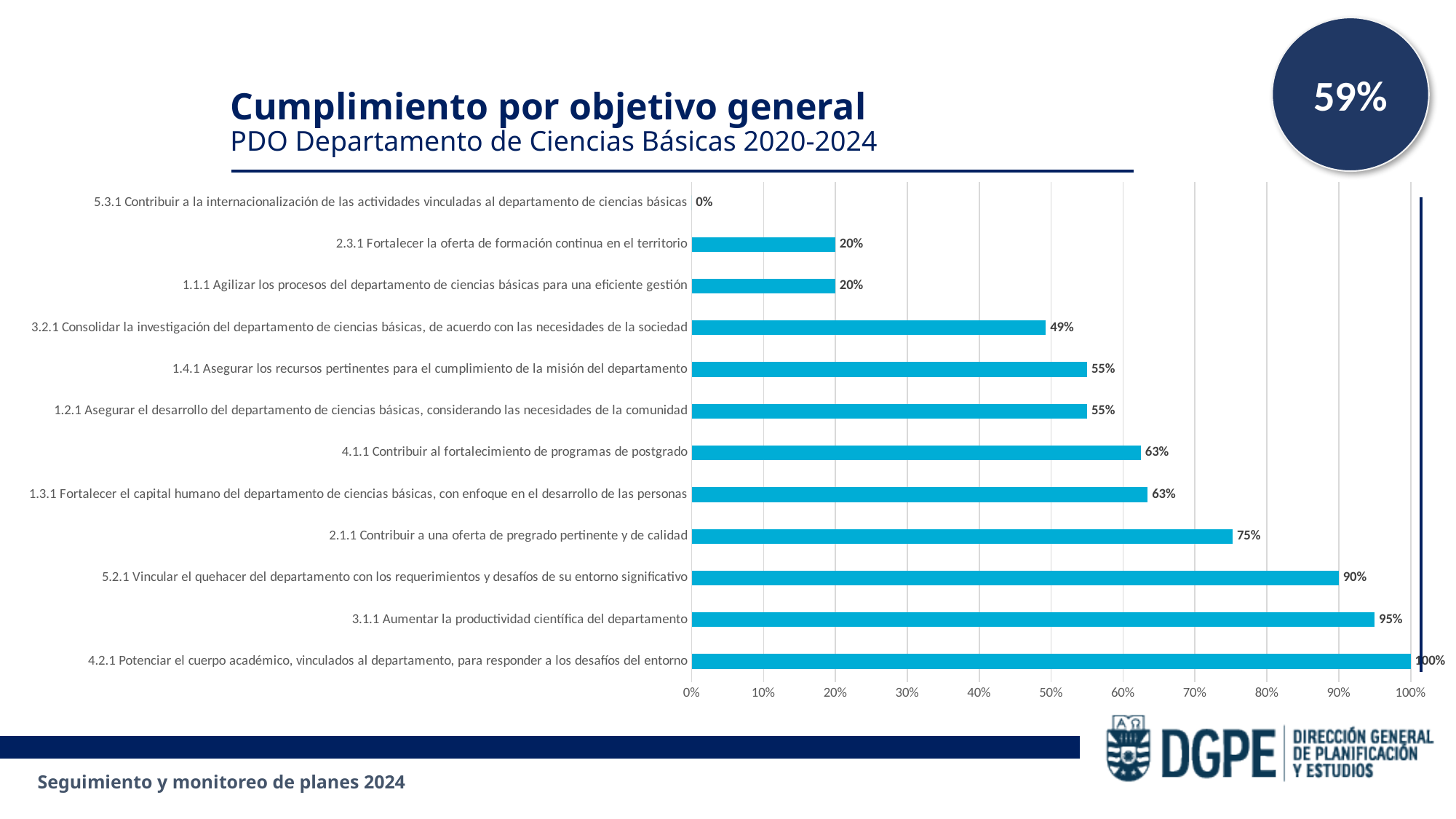
What percentage is shown in the circle at the top right of the slide? 59% What is the value for 1.2.1 Asegurar el desarrollo del departamento de ciencias básicas, considerando las necesidades de la comunidad? 55% What kind of chart is shown on the slide? Bar chart Which objective has the lowest value? 5.3.1 Contribuir a la internacionalización de las actividades vinculadas al departamento de ciencias básicas What is the value for 2.1.1 Contribuir a una oferta de pregrado pertinente y de calidad? 75% What is the title of the chart? Cumplimiento por objetivo general What is the value for 5.2.1 Vincular el quehacer del departamento con los requerimientos y desafíos de su entorno significativo? 90% What is the value for 3.2.1 Consolidar la investigación del departamento de ciencias básicas, de acuerdo con las necesidades de la sociedad? 49% Which objective has the highest value? 4.2.1 Potenciar el cuerpo académico, vinculados al departamento, para responder a los desafíos del entorno What is the difference between the values for 3.1.1 Aumentar la productividad científica del departamento and 2.1.1 Contribuir a una oferta de pregrado pertinente y de calidad? 20% How many objectives are shown in the chart? 12 Which is larger: the value for 4.1.1 Contribuir al fortalecimiento de programas de postgrado or the value for 1.4.1 Asegurar los recursos pertinentes para el cumplimiento de la misión del departamento? 4.1.1 Contribuir al fortalecimiento de programas de postgrado